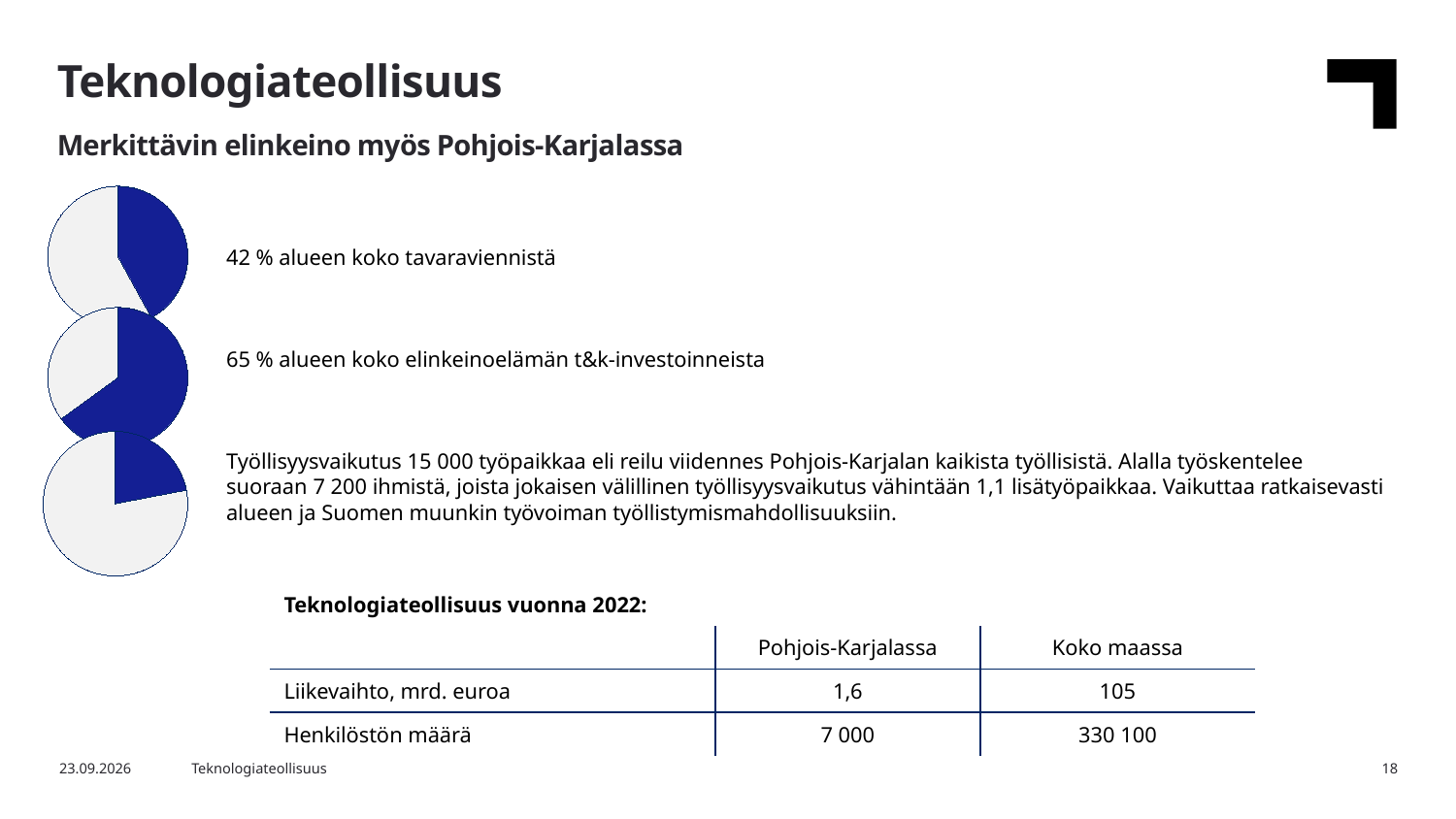
Which pie chart has the smallest highlighted (blue) slice: the top, middle or bottom one? Bottom Is the blue slice of the bottom pie chart greater or less than 50% of the pie? less How many slices does each pie chart have? 2 Is the blue slice of the middle pie chart larger or smaller than the blue slice of the top pie chart? Larger What kind of charts are shown on the left side of the slide? Pie charts What is the difference in percentage points between the shares shown for the middle pie chart (65 %) and the top pie chart (42 %)? 23 percentage points For the middle pie chart, what share of the region's business R&D investments does the highlighted slice represent, according to the text next to it? 65 % Is the blue slice of the middle pie chart greater or less than 50% of the pie? greater Which pie chart has the largest highlighted (blue) slice: the top, middle or bottom one? Middle How many pie charts are on the slide? 3 What colour is the highlighted slice in each pie chart? Dark blue For the top pie chart, what share of the region's total goods exports does the highlighted slice represent, according to the text next to it? 42 %